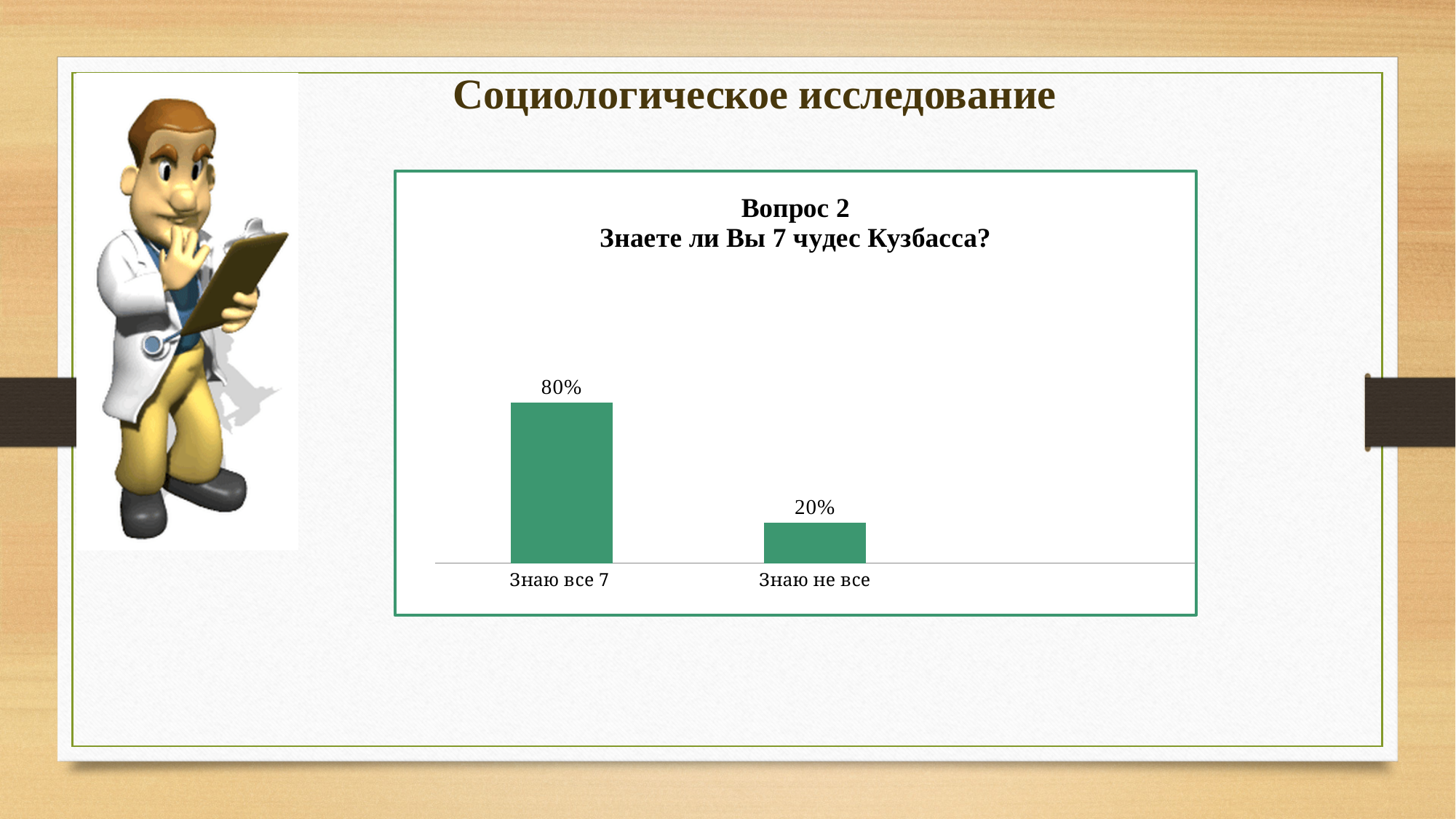
What is the value for "Знаю не все"? 20% What colour are the bars in the chart? Green Which category has the highest value? Знаю все 7 What is the title of the chart? Вопрос 2 Знаете ли Вы 7 чудес Кузбасса? What is the difference between the values for "Знаю все 7" and "Знаю не все"? 60% What kind of chart is shown on the slide? Bar chart What is the total of the two values shown in the chart? 100% What is the value for "Знаю все 7"? 80% How many categories are shown in the chart? 2 Which category has the lowest value? Знаю не все Which is larger, the value for "Знаю все 7" or for "Знаю не все"? Знаю все 7 Do the values rise or fall from left to right along the x axis? Fall